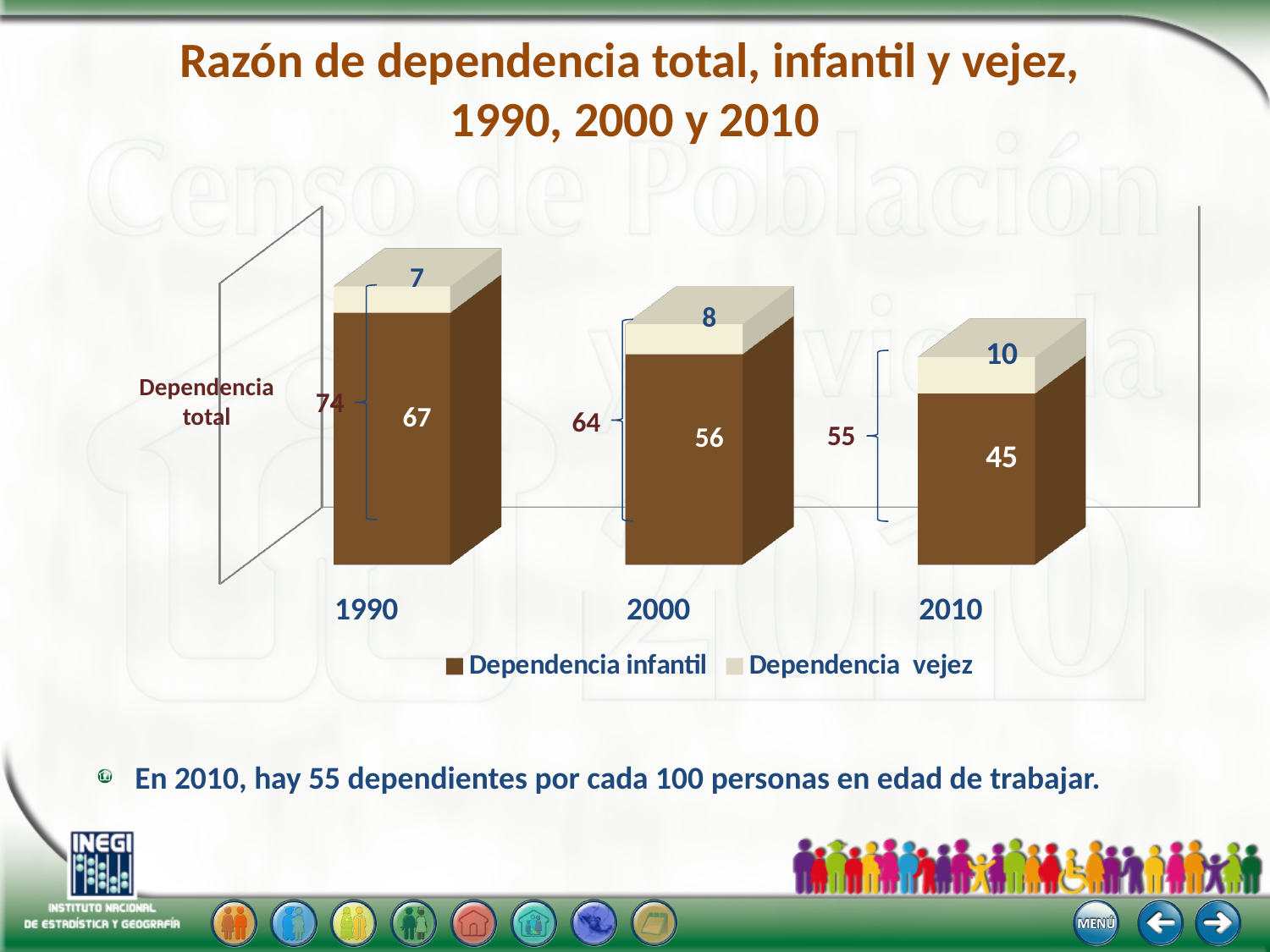
What is the value of Dependencia infantil for 2000? 56 What is the value of Dependencia infantil for 1990? 67 What is the Dependencia total shown for 2000? 64 What kind of chart is shown on the slide? stacked bar chart What is the difference between the Dependencia infantil values for 1990 and 2010? 22 Which year has the highest Dependencia infantil value? 1990 Does the Dependencia total rise or fall from 1990 to 2010? fall How many series does the legend list? 2 Is the Dependencia vejez value for 2010 larger or smaller than the value for 2000? larger What is the value of Dependencia vejez for 2010? 10 Which year has the lowest Dependencia vejez value? 1990 How many years are shown on the x axis? 3